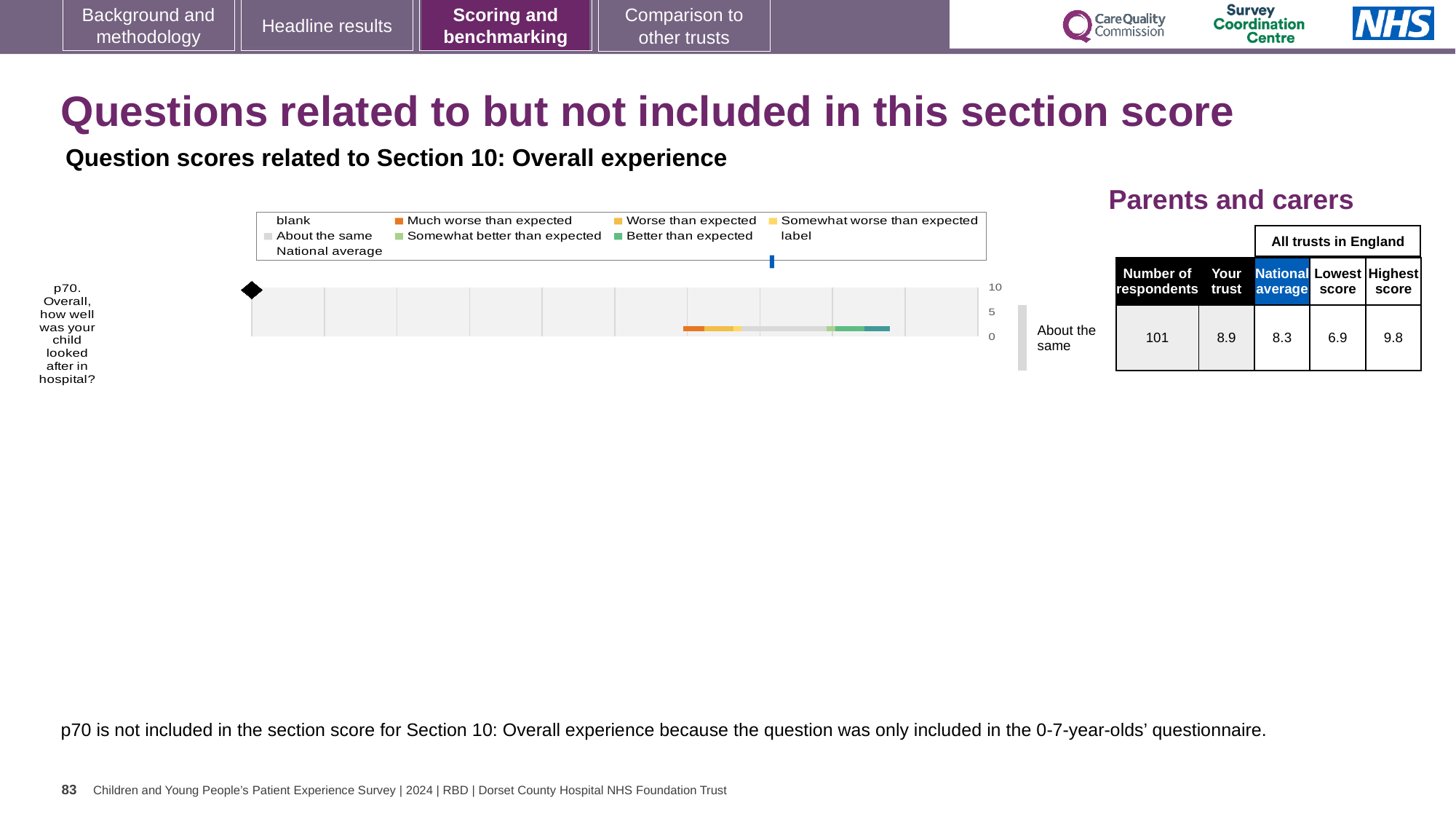
What kind of chart is shown on the slide? bar chart Which is larger for p70, the 'Your trust' score or the national average? Your trust Which question is plotted in the chart? p70. Overall, how well was your child looked after in hospital? What is the difference between the highest and lowest scores among all trusts in England for p70? 2.9 How many respondents answered p70? 101 What benchmark category label is shown to the right of the p70 bar? About the same What is the lowest score among all trusts in England for p70? 6.9 What is the difference between the 'Your trust' score and the national average for p70? 0.6 What is the 'Your trust' score for p70 shown in the table next to the chart? 8.9 What is the national average score for p70 shown in the table next to the chart? 8.3 What is the highest score among all trusts in England for p70? 9.8 How many questions are plotted in the chart? 1